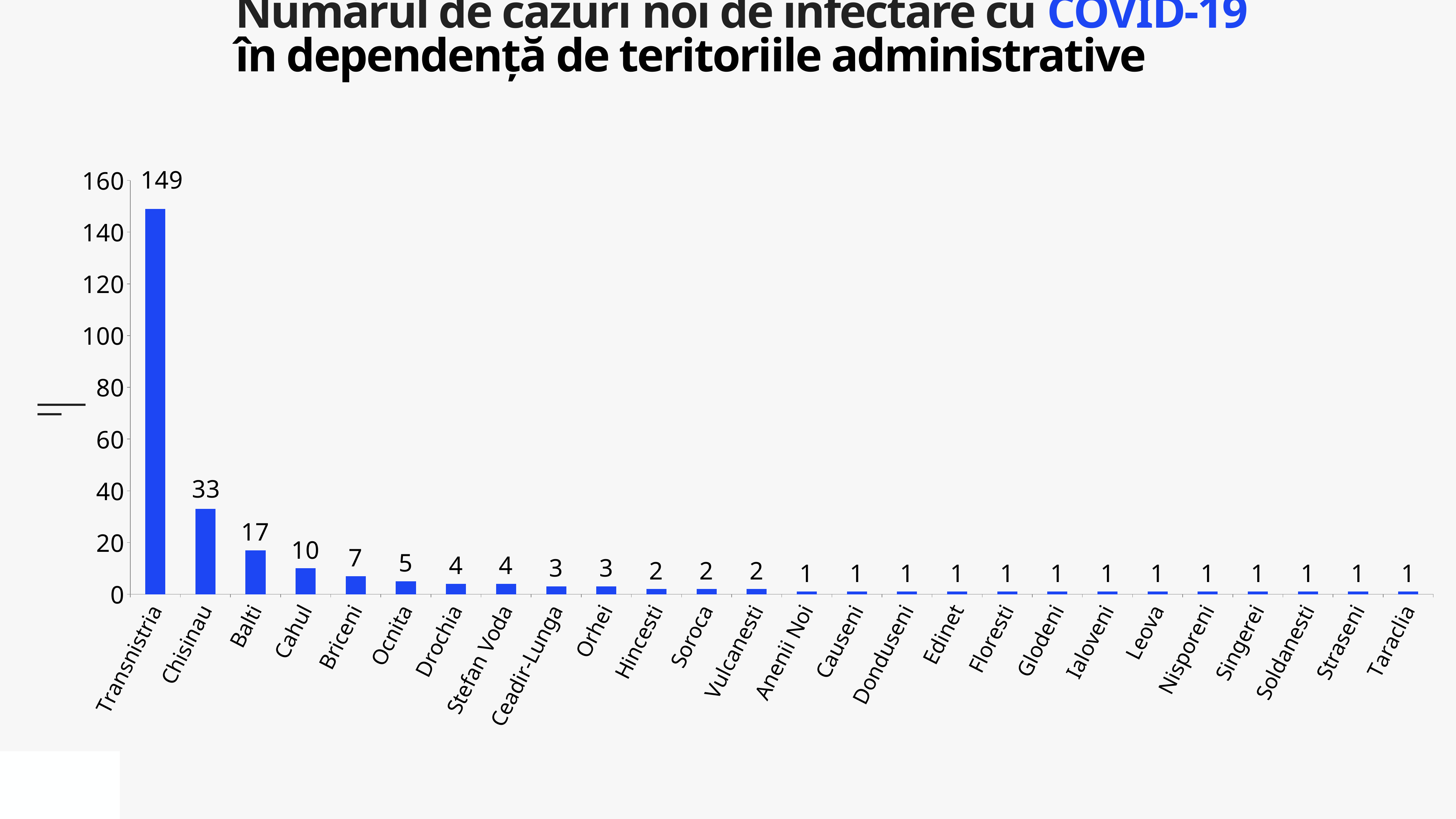
What is the difference between the values for Balti and Cahul? 7 What kind of chart is this? Bar chart Which is larger, the value for Ocnita or the value for Orhei? Ocnita What is the value for Cahul? 10 How many categories are shown on the x axis? 26 What is the value for Briceni? 7 Do the values rise or fall from left to right along the x axis? Fall What is the value for Chisinau? 33 What is the difference between the values for Transnistria and Chisinau? 116 What is the value for Transnistria? 149 What is the value for Balti? 17 Which category has the highest value? Transnistria